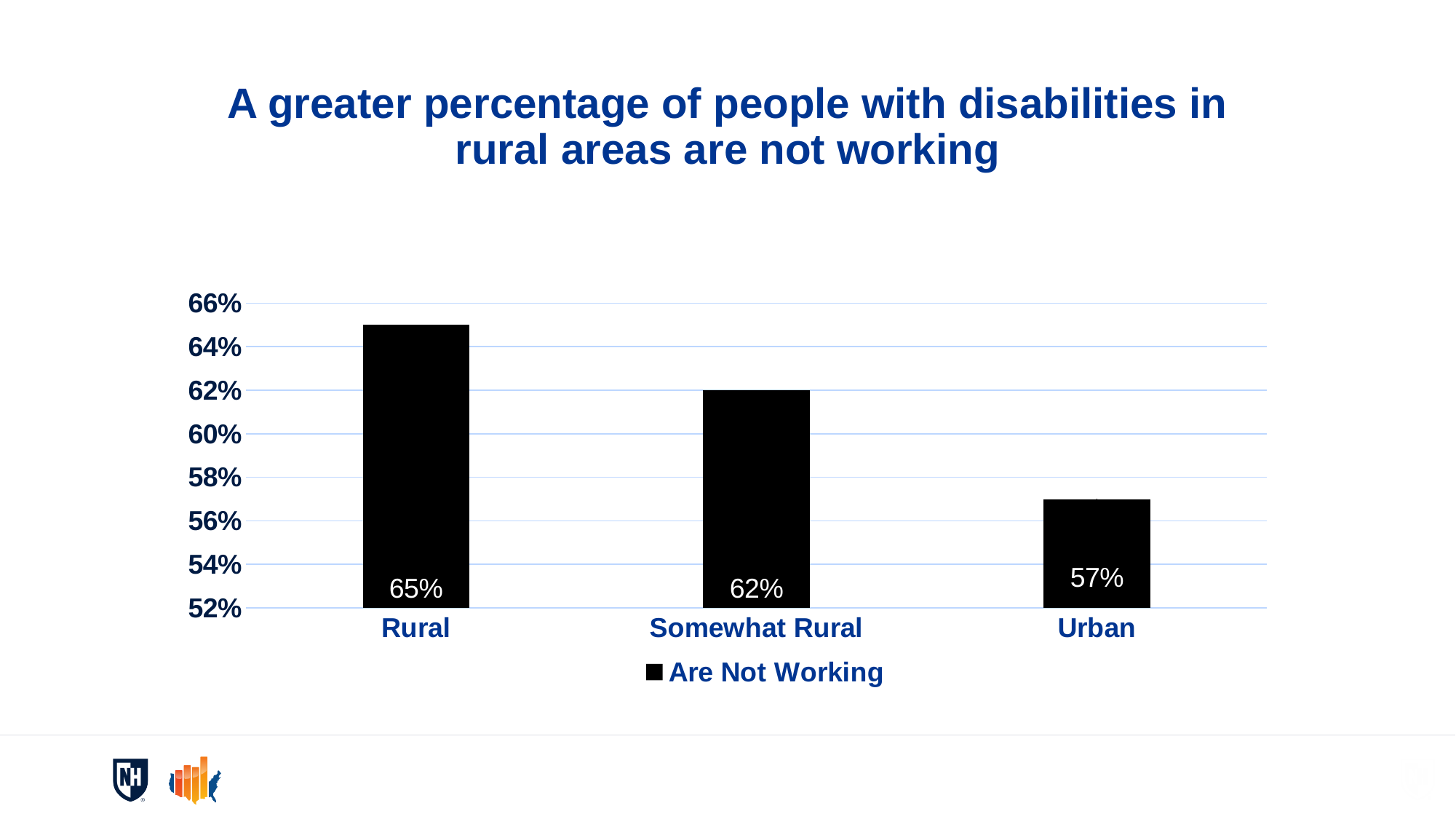
Which is larger, the value for Somewhat Rural or the value for Urban? Somewhat Rural Which category has the highest percentage not working? Rural What is the value for Somewhat Rural? 62% What is the difference between the Rural and Urban values? 8% What is the difference between the Rural and Somewhat Rural values? 3% What kind of chart is shown on the slide? bar chart What series name does the legend show? Are Not Working How many categories are shown on the x axis? 3 Is the value for Urban greater or less than 60%? less What is the value for Urban? 57% Which category has the lowest percentage not working? Urban What percentage of people with disabilities in Rural areas are not working? 65%